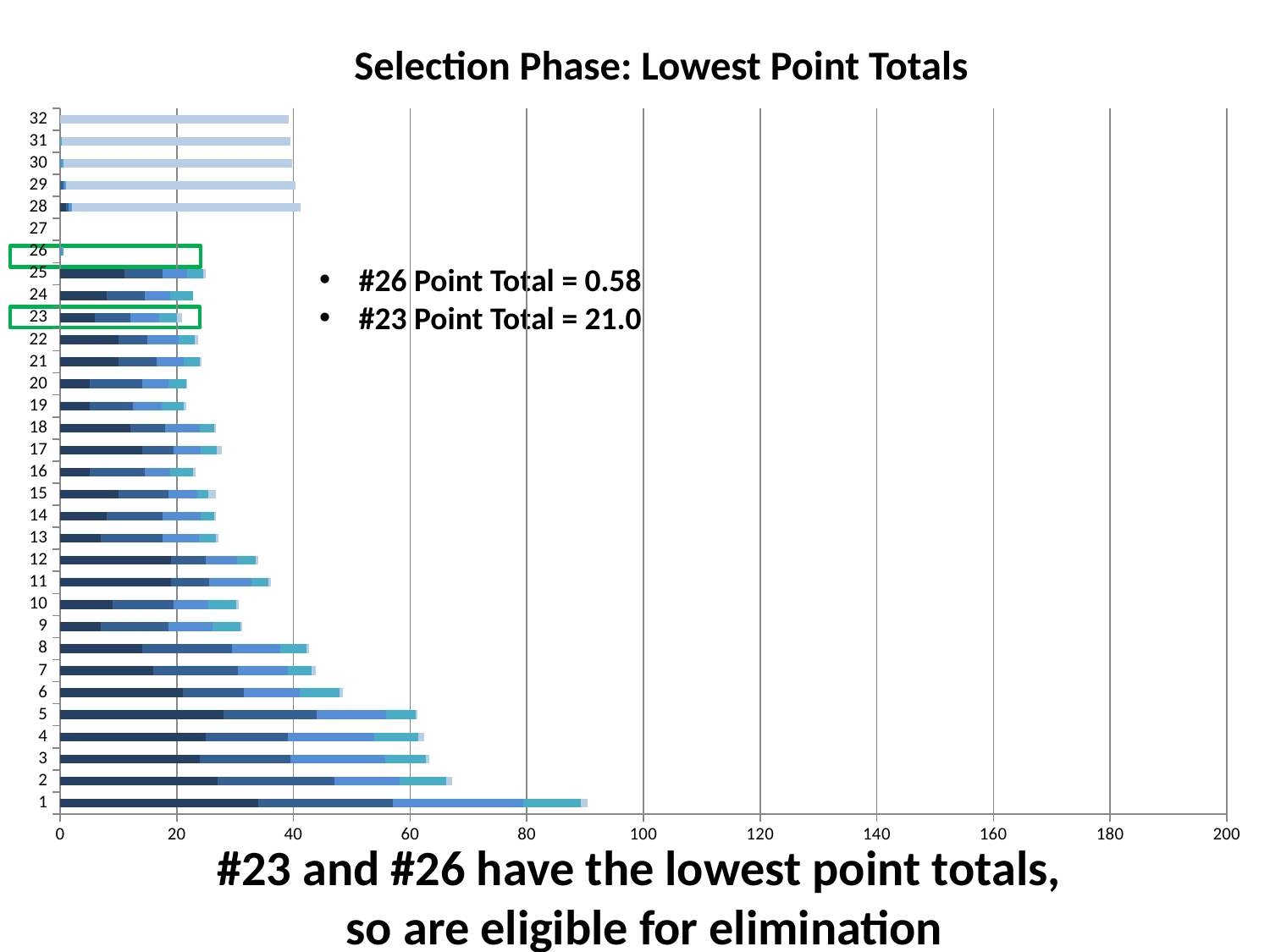
What is the difference between the point totals of #23 and #26? 20.42 What is the point total for #26? 0.58 What is the title of the chart? Selection Phase: Lowest Point Totals Which has the larger total, category 6 or category 7? 6 How many categories are listed on the vertical axis of the chart? 32 What is the point total for #23? 21.0 Which two categories are highlighted with green boxes on the chart? 23 and 26 What kind of chart is shown on the slide? bar chart Which category has the longest bar in the chart? 1 Is the total for category 6 greater or less than 60? less Is the total for category 2 greater or less than 60? greater Is the total for category 1 greater or less than 80? greater